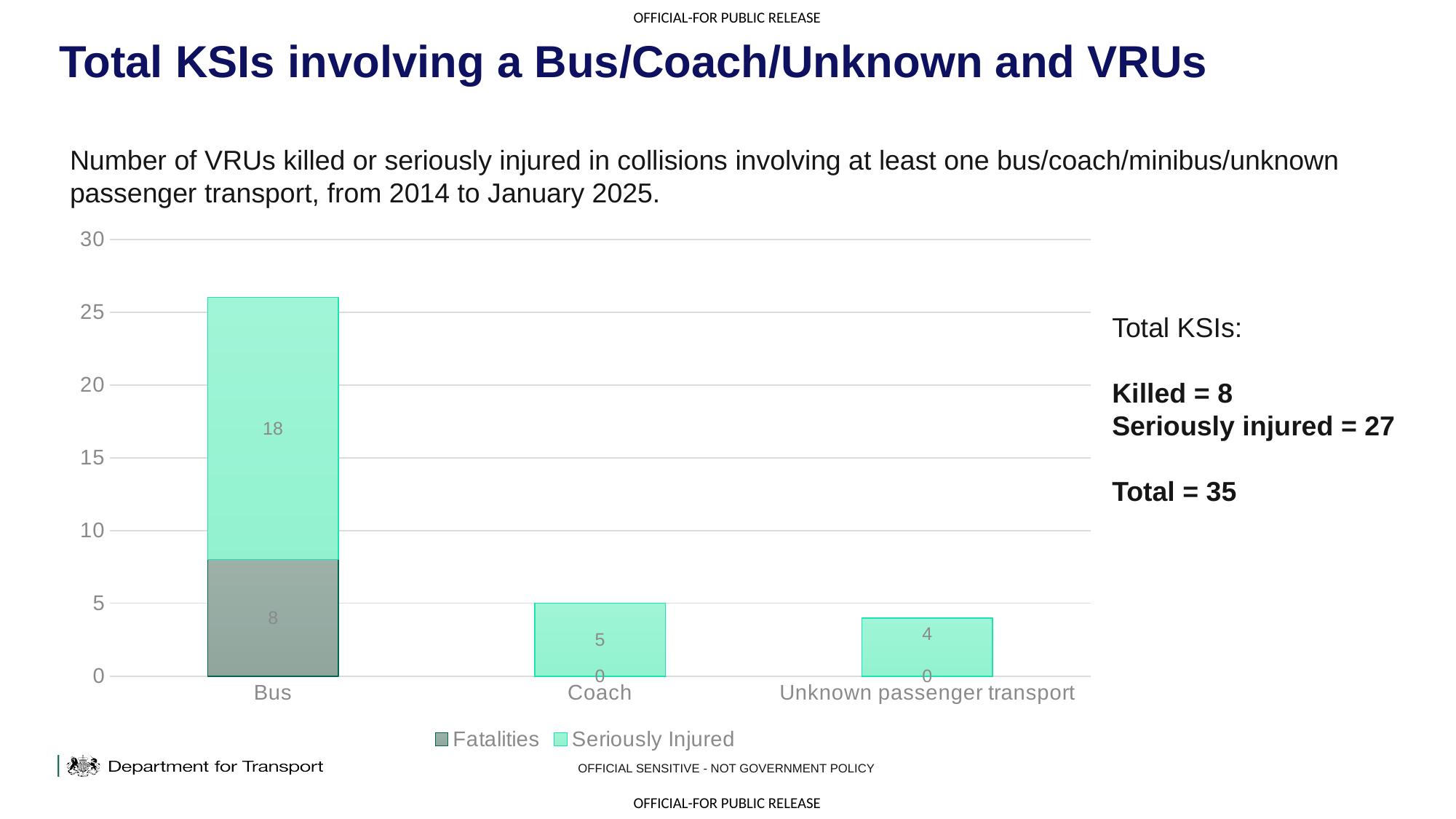
Which category has the lowest Seriously Injured value? Unknown passenger transport What is the Fatalities value for Unknown passenger transport? 0 What is the difference between the Seriously Injured values for Bus and Coach? 13 What kind of chart is shown on the slide? Stacked bar chart Which is larger, the Seriously Injured value for Coach or for Unknown passenger transport? Coach What is the Seriously Injured value for Coach? 5 Which category has the highest total KSIs? Bus How many categories are shown on the x axis? 3 What is the total of the stacked bar for Bus? 26 What is the Fatalities value for Bus? 8 How many series does the legend list? 2 What is the Seriously Injured value for Bus? 18